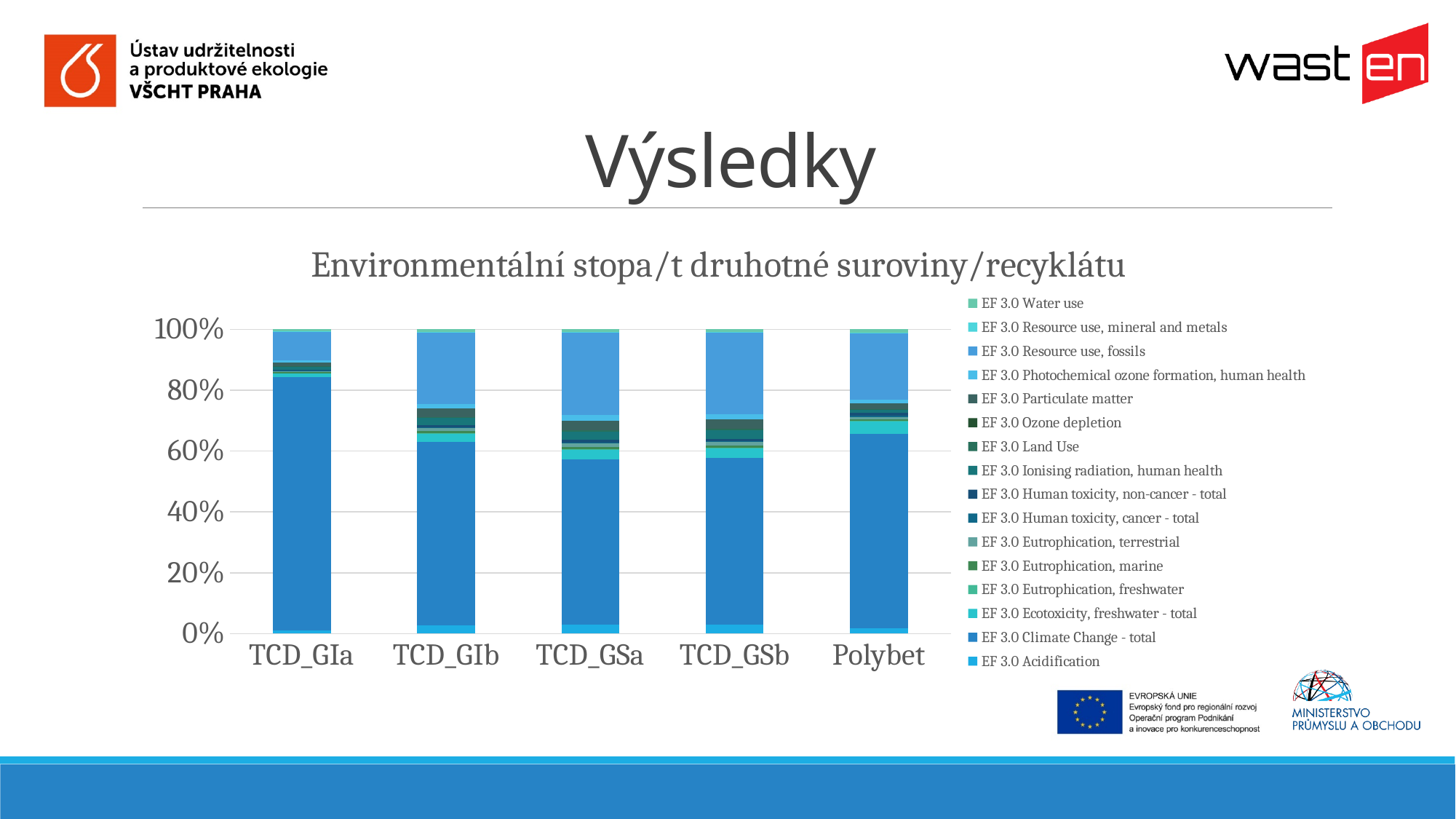
What is the highest value shown on the y axis of the chart? 100% Is the top of the EF 3.0 Climate Change - total segment for TCD_GIa greater or less than 80%? greater Is the top of the EF 3.0 Climate Change - total segment for TCD_GSa greater or less than 60%? less Which category has the largest share for EF 3.0 Climate Change - total? TCD_GIa How many series does the chart legend list? 16 What kind of chart is shown on the slide? stacked bar chart Which has the larger share of EF 3.0 Resource use, fossils, TCD_GIa or TCD_GIb? TCD_GIb How many categories (bars) are shown on the x axis of the chart? 5 Which category is the last (rightmost) bar on the x axis? Polybet Which has the larger share of EF 3.0 Climate Change - total, TCD_GIa or TCD_GSa? TCD_GIa Is the top of the EF 3.0 Climate Change - total segment for Polybet greater or less than 60%? greater What is the title of the chart? Environmentální stopa/t druhotné suroviny/recyklátu